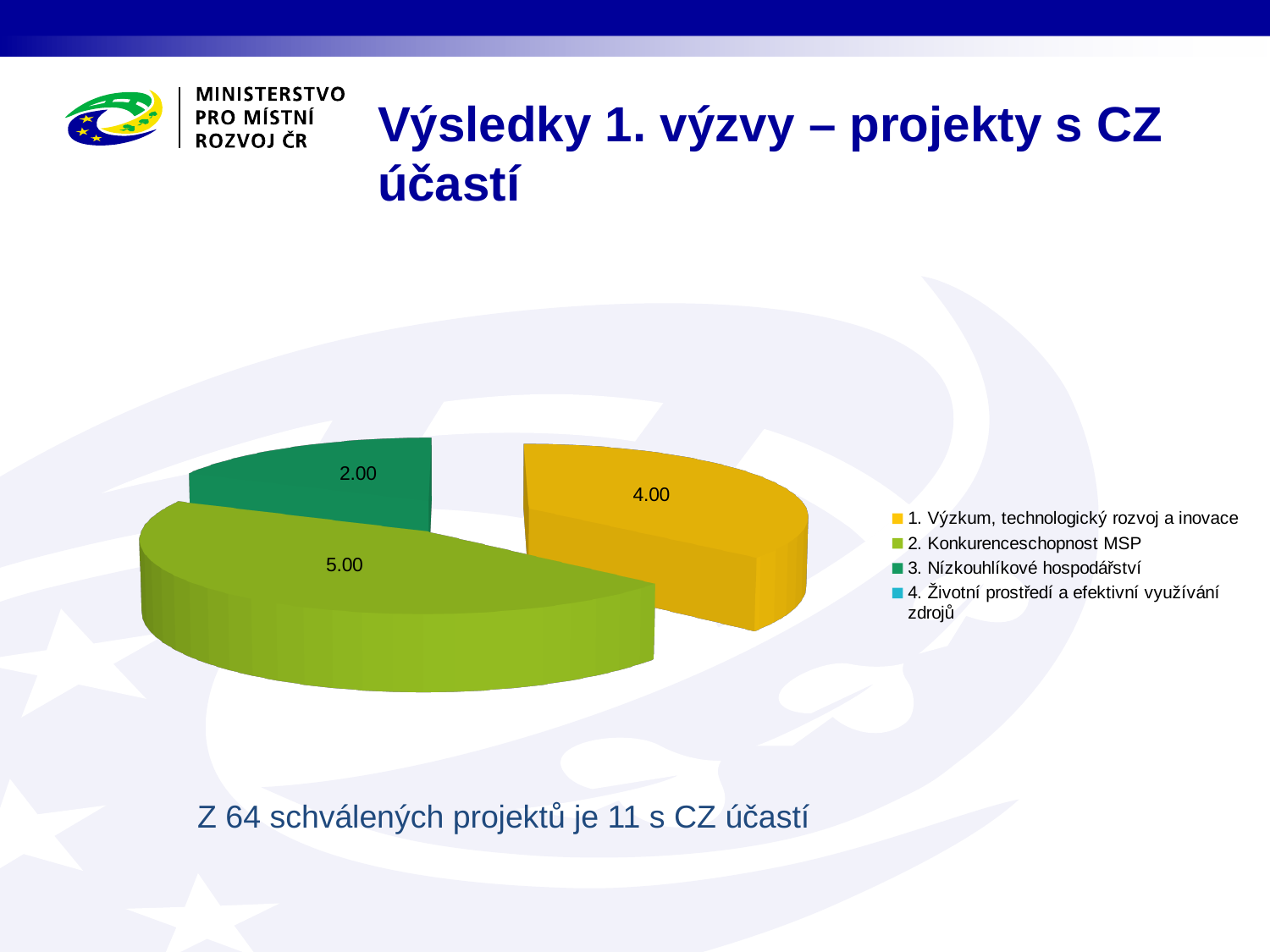
What is the difference between the values for "1. Výzkum, technologický rozvoj a inovace" and "3. Nízkouhlíkové hospodářství"? 2.00 What value is shown for the slice "2. Konkurenceschopnost MSP"? 5.00 Which category has the largest slice in the pie chart? 2. Konkurenceschopnost MSP What value is shown for the slice "1. Výzkum, technologický rozvoj a inovace"? 4.00 How many categories does the legend of the pie chart list? 4 What value is shown for the slice "3. Nízkouhlíkové hospodářství"? 2.00 Which labelled slice in the pie chart has the smallest value? 3. Nízkouhlíkové hospodářství What kind of chart is shown on the slide? Pie chart What colour is the slice for "1. Výzkum, technologický rozvoj a inovace"? Yellow How many slices with data labels are visible in the pie chart? 3 Which is larger: the slice for "1. Výzkum, technologický rozvoj a inovace" or the slice for "3. Nízkouhlíkové hospodářství"? 1. Výzkum, technologický rozvoj a inovace What is the difference between the values for "2. Konkurenceschopnost MSP" and "1. Výzkum, technologický rozvoj a inovace"? 1.00